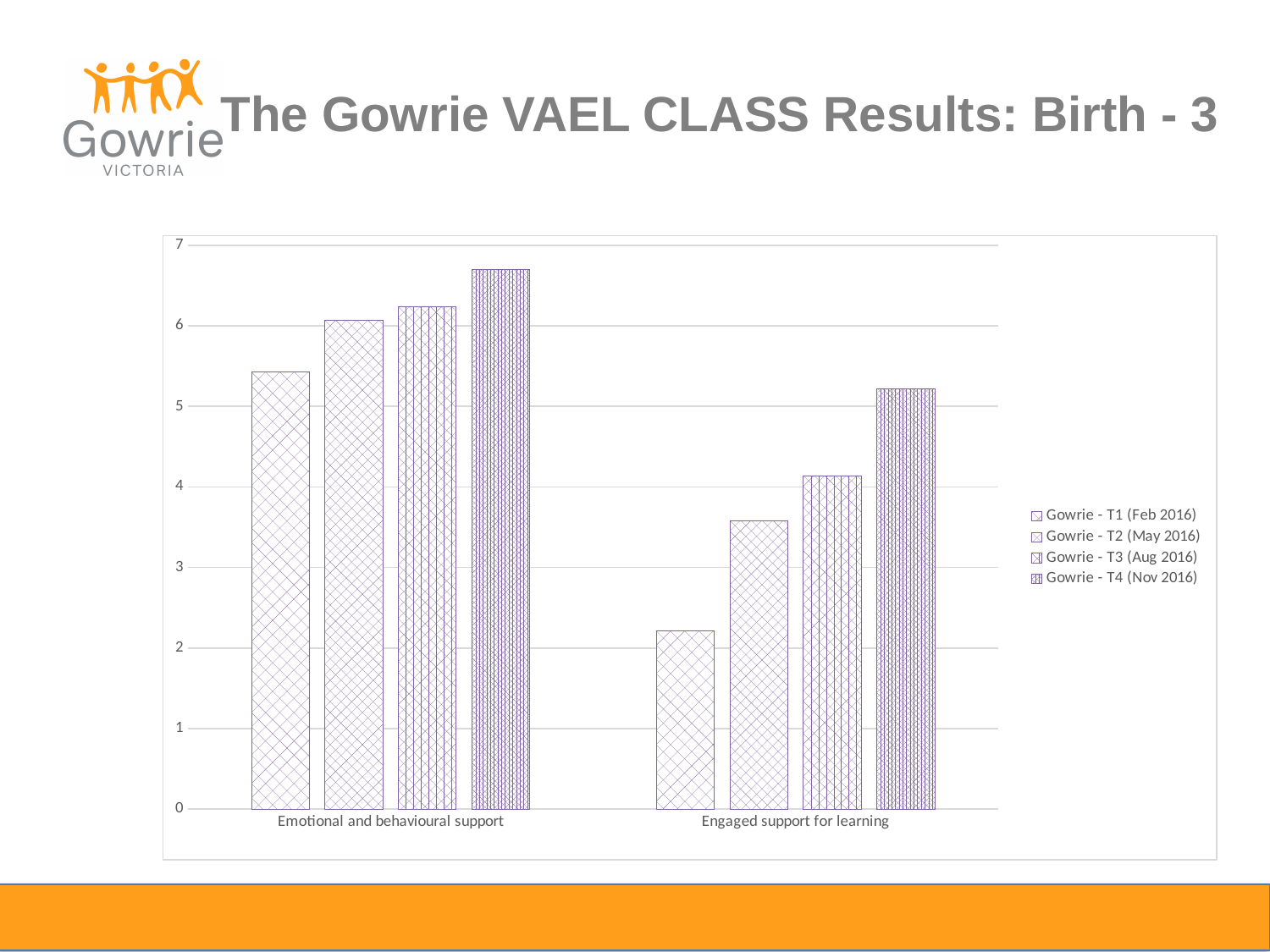
Is the value for Gowrie - T4 (Nov 2016) in Emotional and behavioural support greater or less than 7? less What is the title of the slide containing the chart? The Gowrie VAEL CLASS Results: Birth - 3 Which series has the lowest value for Engaged support for learning? Gowrie - T1 (Feb 2016) Which is larger: the Gowrie - T2 (May 2016) value for Emotional and behavioural support or for Engaged support for learning? Emotional and behavioural support What kind of chart is shown on the slide? bar chart Is the value for Gowrie - T1 (Feb 2016) in Engaged support for learning greater or less than 3? less Is the value for Gowrie - T1 (Feb 2016) in Emotional and behavioural support greater or less than 5? greater How many series does the legend list? 4 Do the values for Engaged support for learning rise or fall from T1 (Feb 2016) to T4 (Nov 2016)? rise Which series has the highest value for Emotional and behavioural support? Gowrie - T4 (Nov 2016) How many categories are shown on the x axis? 2